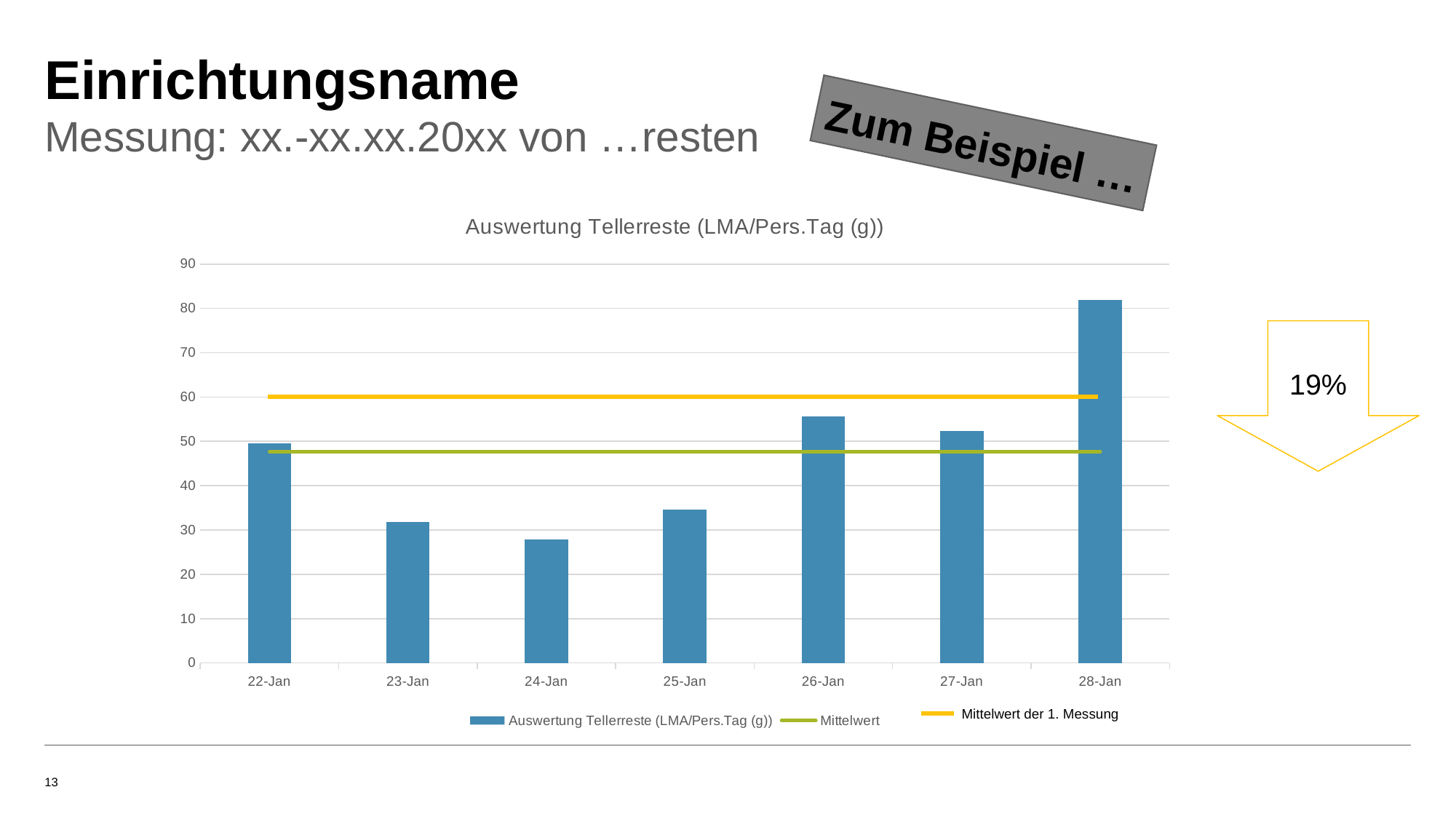
Which date has the lowest bar in the chart? 24-Jan Is the value for 24-Jan greater or less than 30? less Is the value for 23-Jan greater or less than 40? less Which has the larger value, 26-Jan or 23-Jan? 26-Jan What kind of chart is shown on the slide? bar and line chart Do the bar values rise or fall from 22-Jan to 24-Jan? fall How many dates are shown on the x axis of the chart? 7 What is the title of the chart? Auswertung Tellerreste (LMA/Pers.Tag (g)) Is the value for 28-Jan greater or less than 70? greater How many series does the chart legend list? 3 Which date has the highest bar in the chart? 28-Jan